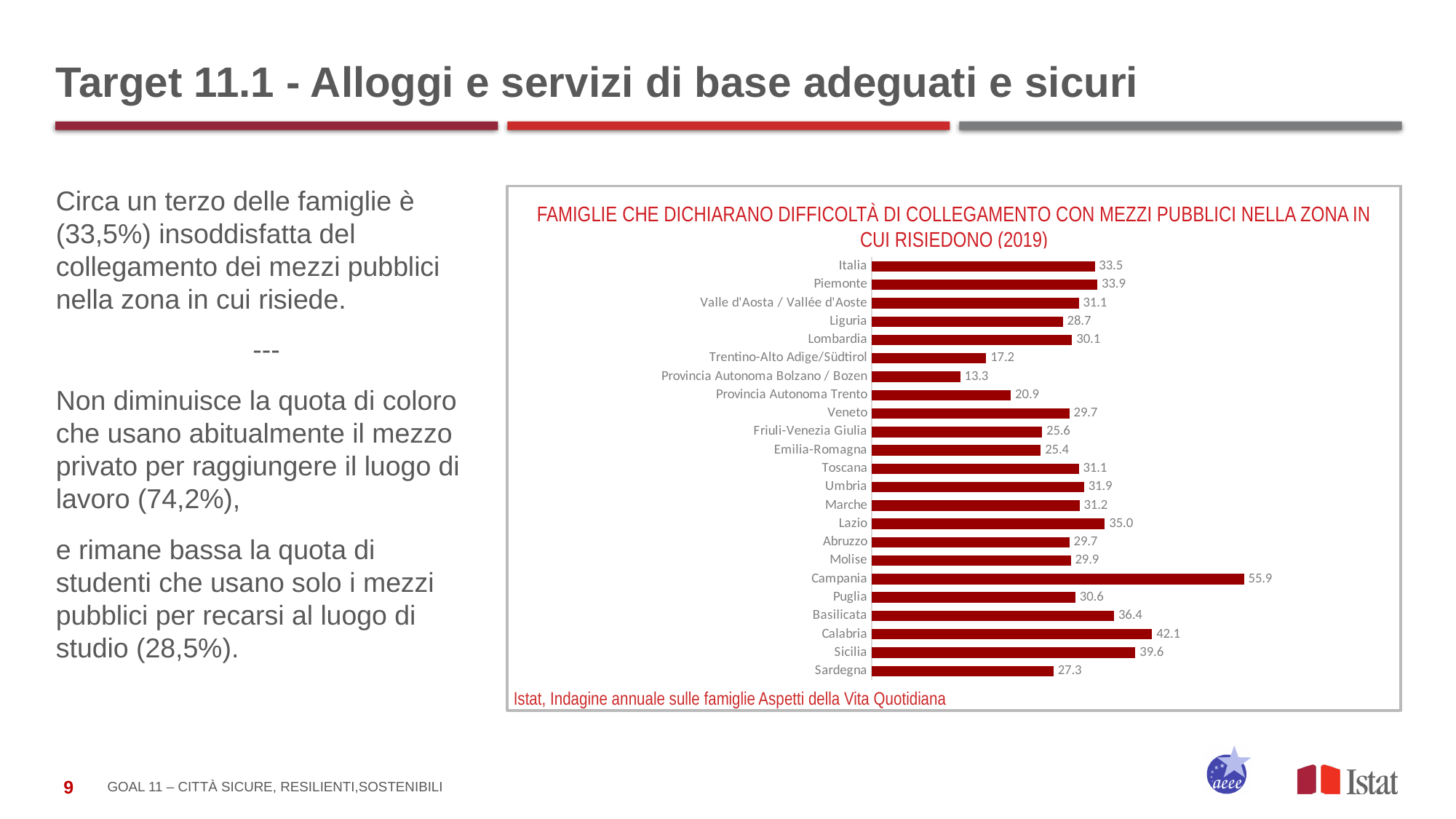
Which category has the highest value? Campania What is the difference between the values for Campania and Italia? 22.4 What is the value for Campania? 55.9 Which has a larger value, Lazio or Sardegna? Lazio What source is cited below the chart? Istat, Indagine annuale sulle famiglie Aspetti della Vita Quotidiana What is the value for Italia? 33.5 How many categories are shown in the chart? 23 Which category has the lowest value? Provincia Autonoma Bolzano / Bozen What is the value for Provincia Autonoma Trento? 20.9 What kind of chart is shown on the slide? Bar chart What is the difference between the values for Calabria and Sicilia? 2.5 Which has a larger value, Basilicata or Puglia? Basilicata